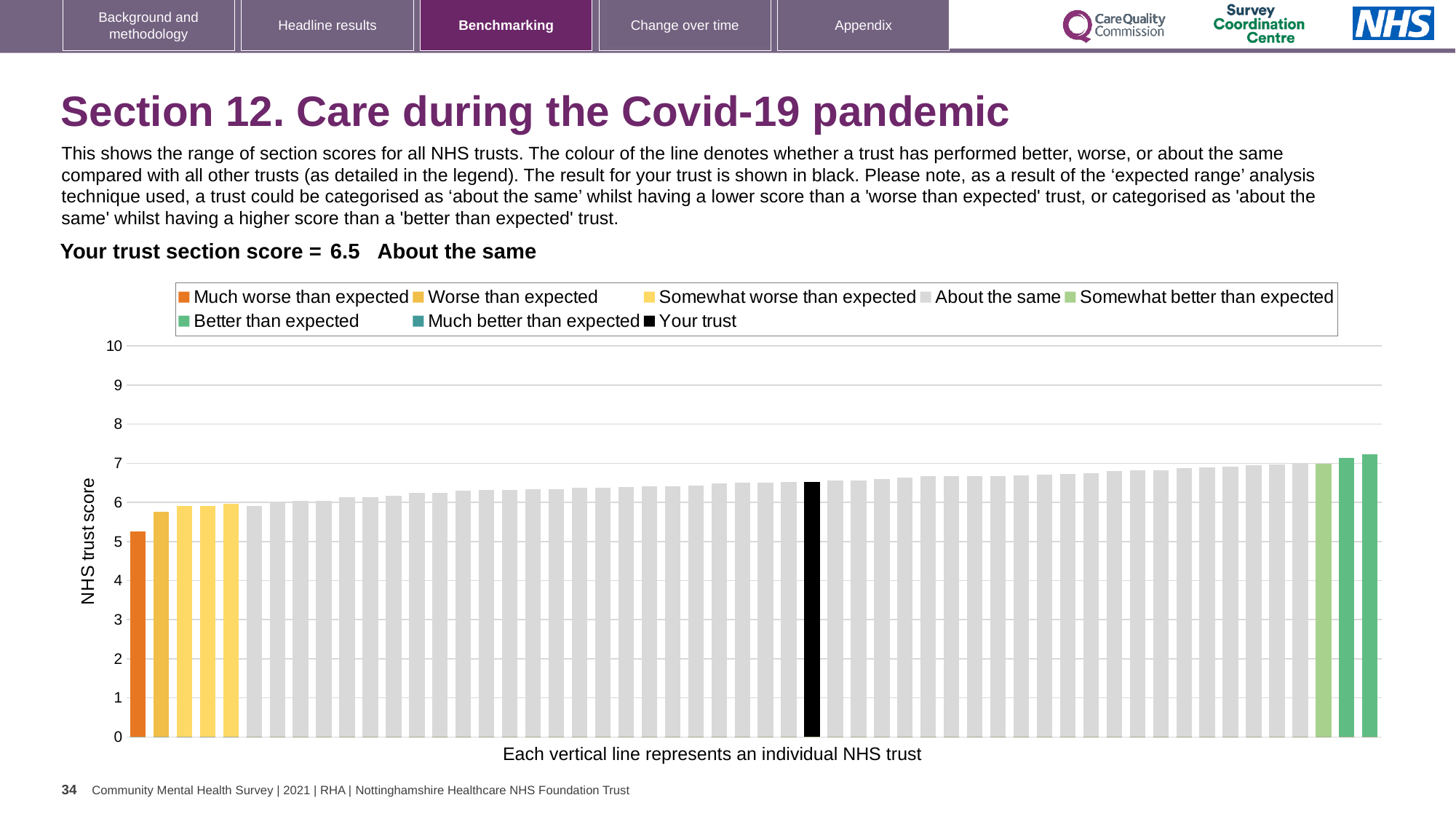
Do the bar values rise or fall moving from left to right along the x axis? rise How many bars are coloured as 'Better than expected'? 2 What colour is used for the bar representing your trust? black Which performance category is your trust placed in for this section? About the same How many bars are coloured as 'Much worse than expected'? 1 What is the label on the vertical axis of the chart? NHS trust score Is the value of the lowest bar (the orange one) greater or less than 6? less Is the value of the black bar (your trust) greater or less than 6? greater How many entries does the chart legend list? 8 Is the value of the highest bar on the chart greater or less than 7? greater What kind of chart is shown on the slide? bar chart What is the section score for your trust shown on the slide? 6.5